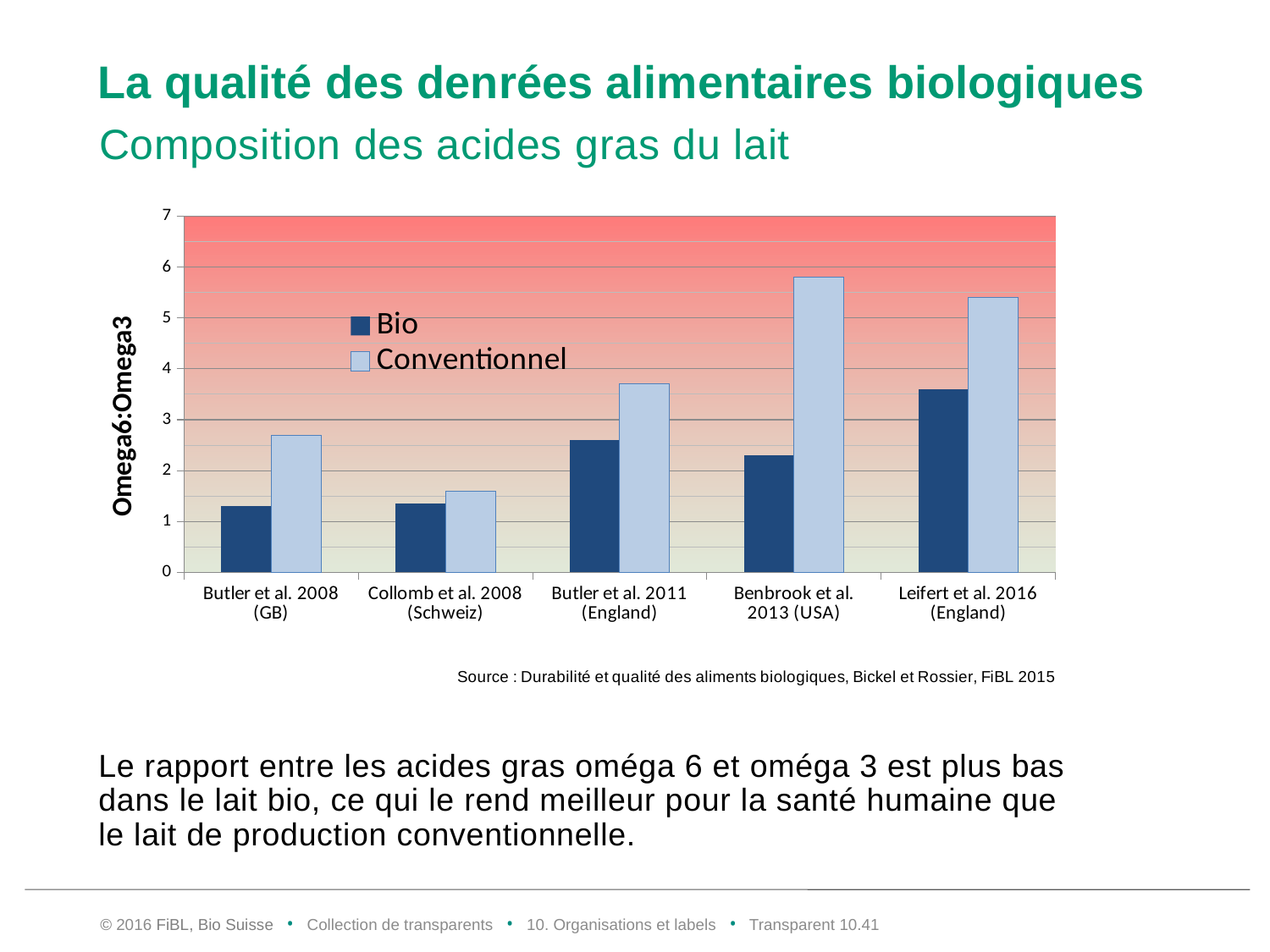
What is the label of the y axis? Omega6:Omega3 What kind of chart is shown on the slide? bar chart Is the Conventionnel value for Benbrook et al. 2013 (USA) greater or less than 5? greater Which study has the highest Bio value? Leifert et al. 2016 (England) Which study has the lowest Conventionnel value? Collomb et al. 2008 (Schweiz) Which study has the highest Conventionnel value? Benbrook et al. 2013 (USA) How many series does the legend list? 2 Which is larger: the Bio value for Butler et al. 2011 (England) or the Bio value for Benbrook et al. 2013 (USA)? Butler et al. 2011 (England) Is the Bio value for Leifert et al. 2016 (England) greater or less than 3? greater How many studies (categories) are shown on the x axis? 5 In every study, which series has the higher Omega6:Omega3 ratio, Bio or Conventionnel? Conventionnel Is the Conventionnel value for Collomb et al. 2008 (Schweiz) greater or less than 2? less